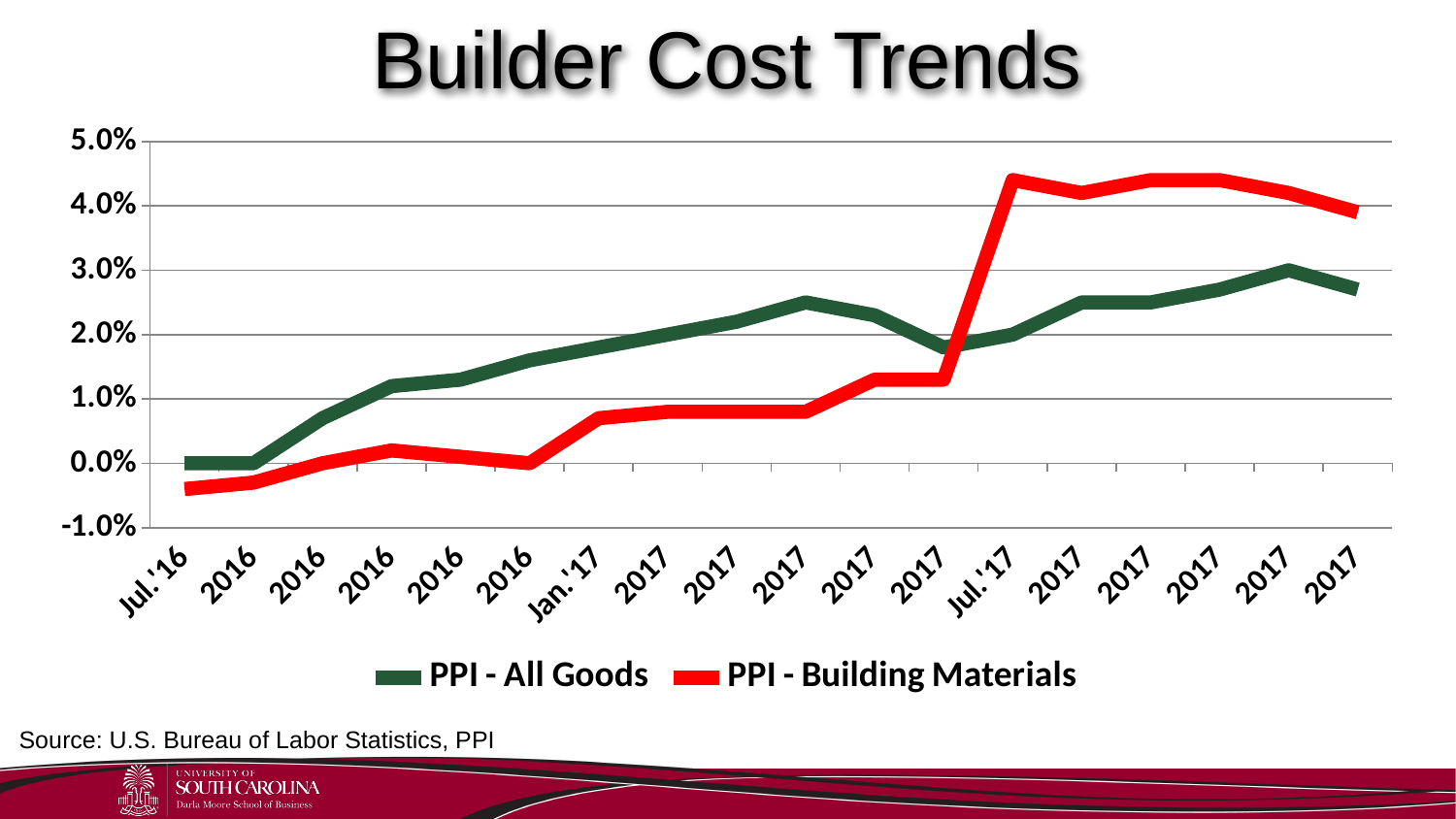
Is the value for PPI - Building Materials at Jul.'16 greater or less than 0.0%? less How many data points are plotted along the x axis for each series? 18 At Jul.'17, which series has the higher value, PPI - All Goods or PPI - Building Materials? PPI - Building Materials At Jan.'17, which series has the higher value, PPI - All Goods or PPI - Building Materials? PPI - All Goods What are the two series named in the legend? PPI - All Goods and PPI - Building Materials What kind of chart is shown on the slide? line chart Is the value for PPI - All Goods at Jul.'16 greater or less than 1.0%? less How many series does the legend list? 2 Does the PPI - All Goods line rise or fall from Jul.'16 to Jan.'17? rise What is the title of the chart? Builder Cost Trends Is the value for PPI - Building Materials at Jul.'17 greater or less than 4.0%? greater